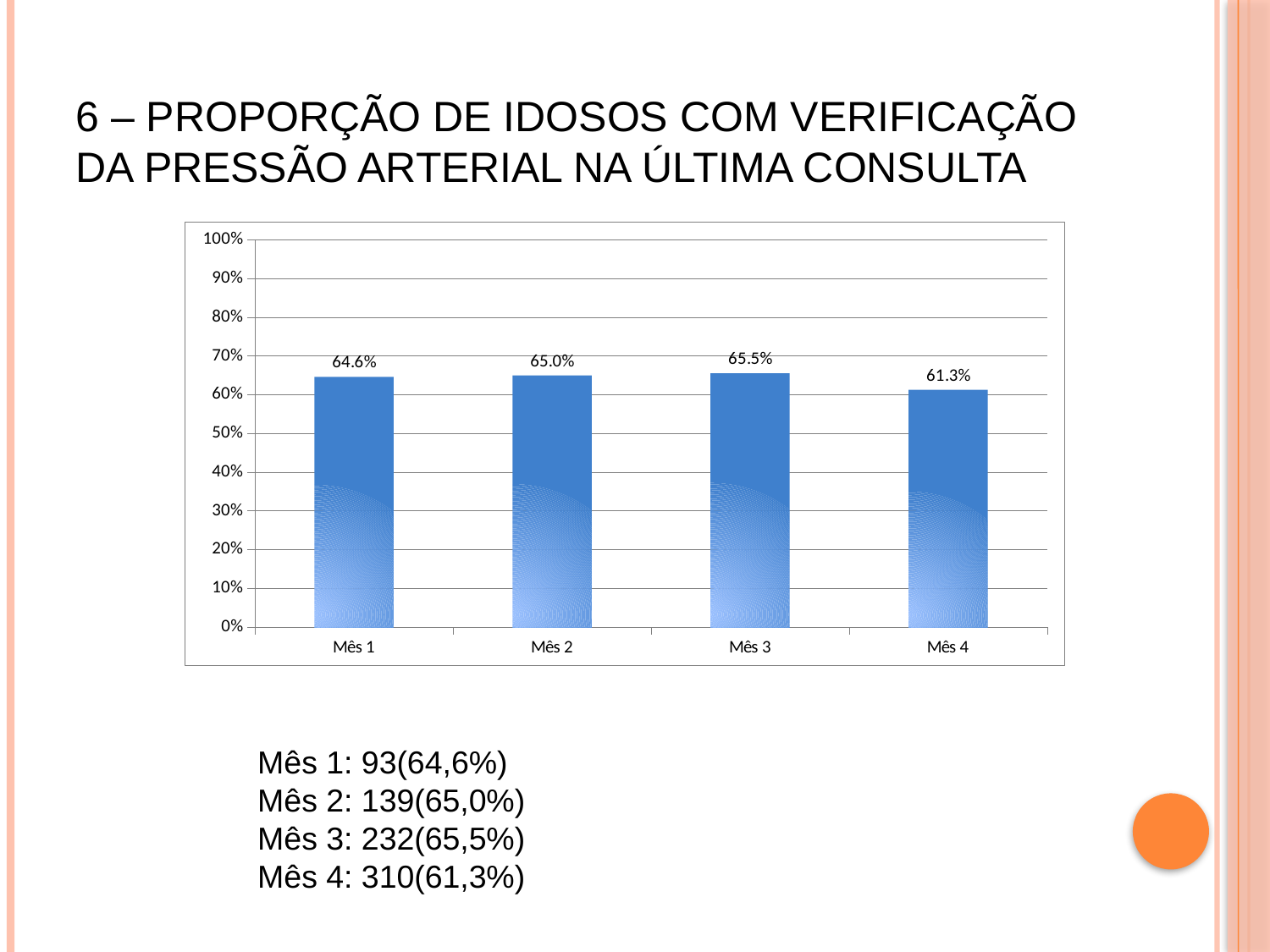
What is the value for Mês 3? 65.5% What is the difference between the values for Mês 3 and Mês 4? 4.2% What is the value for Mês 4? 61.3% Which month has the lowest value? Mês 4 Which is larger, the value for Mês 2 or the value for Mês 4? Mês 2 What is the highest value shown on the y axis? 100% How many months are shown on the x axis? 4 What is the difference between the values for Mês 2 and Mês 1? 0.4% What kind of chart is shown on the slide? bar chart Which month has the highest value? Mês 3 Is the value for Mês 4 greater or less than 70%? less What is the value for Mês 1? 64.6%